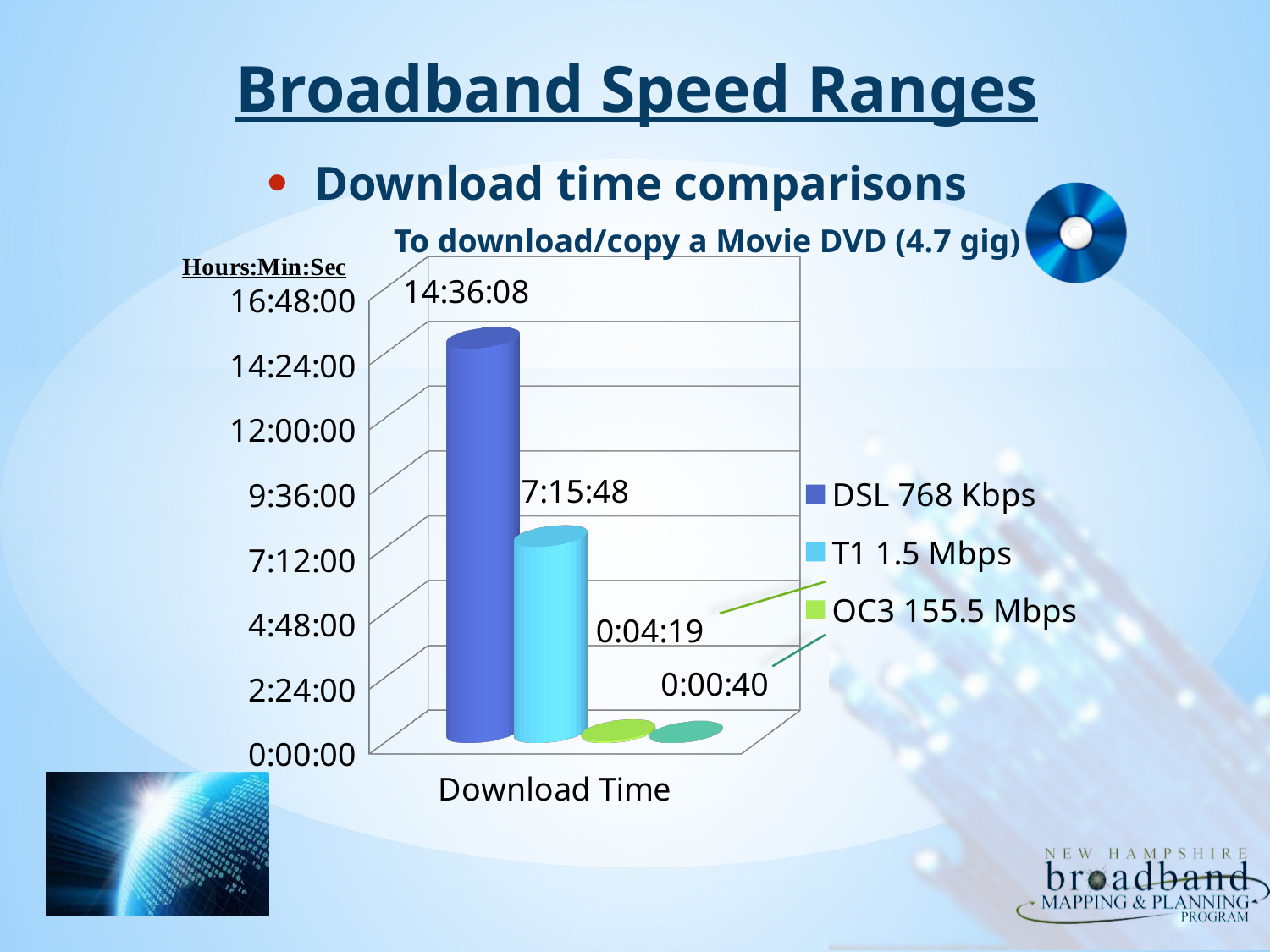
What is the download time for DSL 768 Kbps? 14:36:08 What is the difference in download time between DSL 768 Kbps and T1 1.5 Mbps? 7:20:20 What is the download time for T1 1.5 Mbps? 7:15:48 What is the download time for OC3 155.5 Mbps? 0:04:19 Is the download time for T1 1.5 Mbps greater or less than 9:36:00? less What is the title of the chart? To download/copy a Movie DVD (4.7 gig) Which takes less time to download the DVD, T1 1.5 Mbps or OC3 155.5 Mbps? OC3 155.5 Mbps Which takes longer to download the DVD, DSL 768 Kbps or T1 1.5 Mbps? DSL 768 Kbps What type of chart is shown on the slide? bar chart How many entries does the chart's legend list? 3 How many bars are plotted in the chart? 4 Which connection type has the longest download time? DSL 768 Kbps